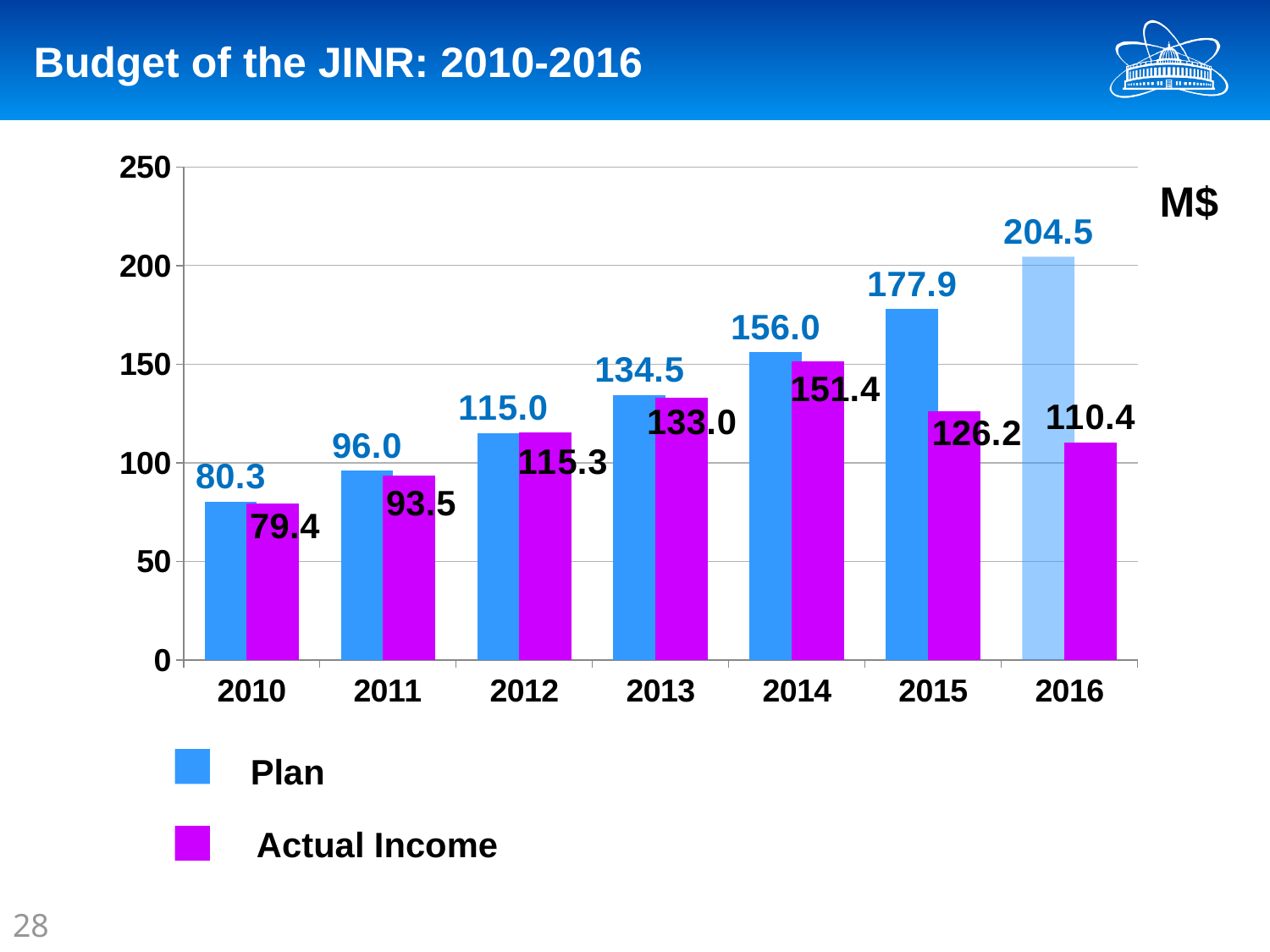
Do the Plan values rise or fall from 2010 to 2016? rise Is the Actual Income value for 2016 greater or less than 150? less What is the Plan value for 2016? 204.5 How many series does the legend list? 2 Which is larger for 2012: the Plan value or the Actual Income value? Actual Income What is the Actual Income value for 2014? 151.4 How many years are shown on the x axis? 7 What kind of chart is shown on the slide? bar chart What is the difference between the Plan and Actual Income values for 2015? 51.7 Which year has the lowest Actual Income value? 2010 What is the Actual Income value for 2010? 79.4 Which year has the highest Plan value? 2016